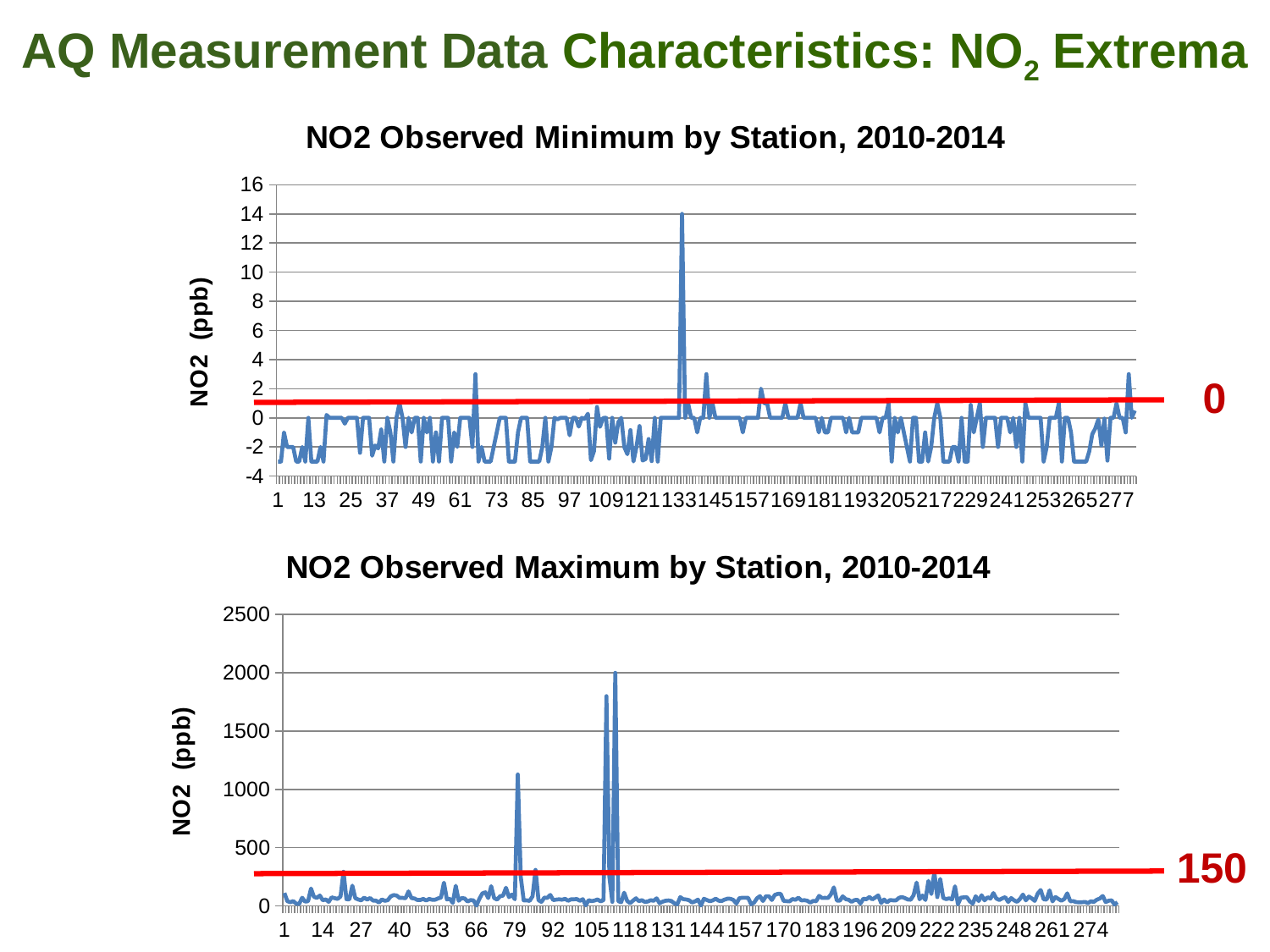
In the "NO2 Observed Minimum by Station, 2010-2014" chart, is the value at station 1 greater or less than 0? less What kind of chart is "NO2 Observed Minimum by Station, 2010-2014"? line chart In the "NO2 Observed Minimum by Station, 2010-2014" chart, is the highest peak of the line greater or less than 12? greater What value does the red line annotation in the bottom chart mark? 150 How many charts are shown on the slide? 2 What is the lowest y-axis tick value on the "NO2 Observed Minimum by Station, 2010-2014" chart? -4 What is the y-axis label of the "NO2 Observed Maximum by Station, 2010-2014" chart? NO2 (ppb) In the "NO2 Observed Maximum by Station, 2010-2014" chart, is the value at station 1 greater or less than 500? less What kind of chart is "NO2 Observed Maximum by Station, 2010-2014"? line chart What is the highest y-axis tick value on the "NO2 Observed Maximum by Station, 2010-2014" chart? 2500